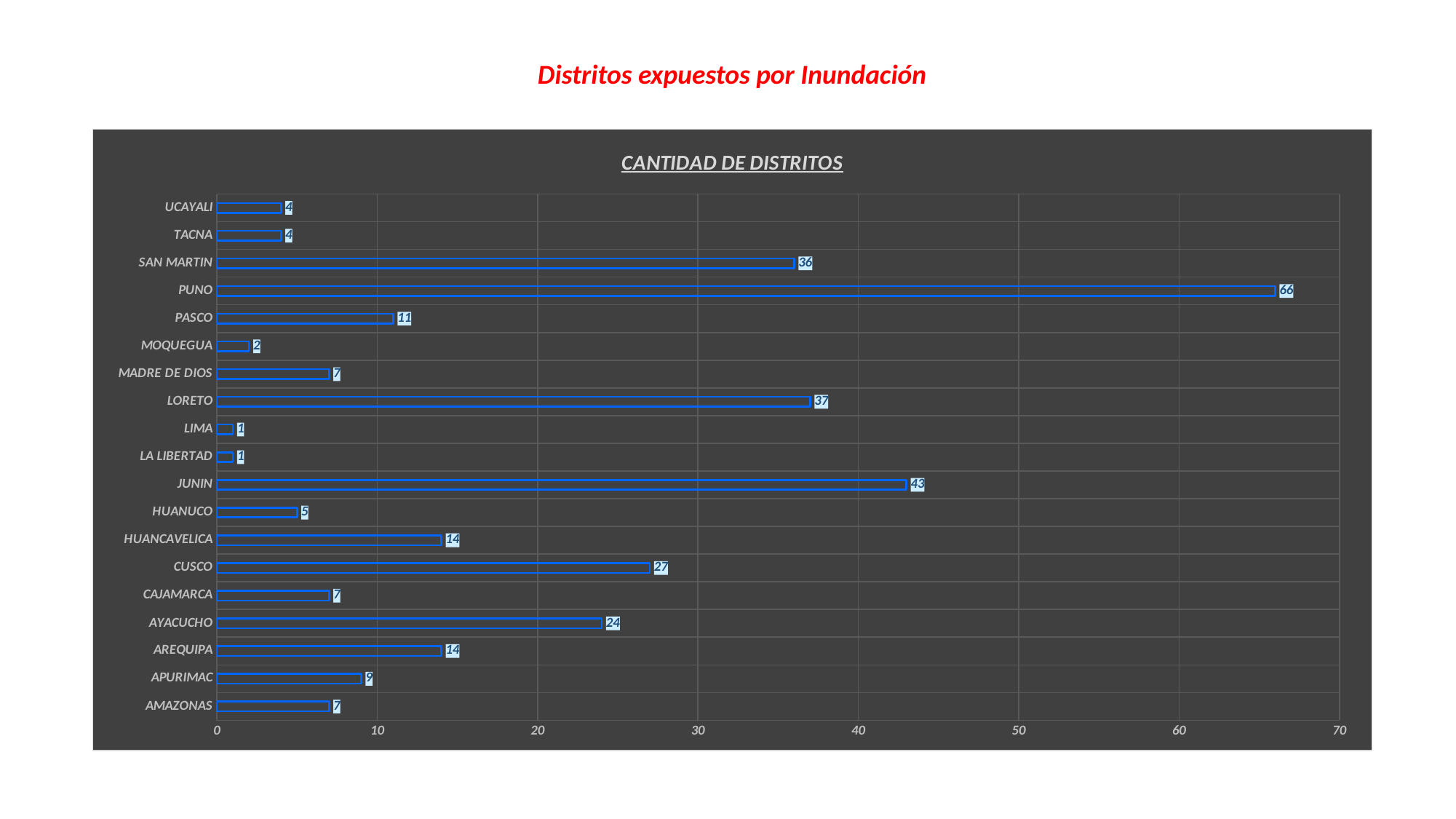
What kind of chart is shown on the slide? bar chart What is the value for LORETO? 37 What is the value for MOQUEGUA? 2 Is the value for PUNO greater or less than 60? greater What is the difference between the values for CUSCO and AYACUCHO? 3 What is the title of the chart? CANTIDAD DE DISTRITOS What is the value for PUNO? 66 How many categories are shown in the chart? 19 Which is larger, the value for JUNIN or the value for CUSCO? JUNIN What is the difference between the values for PUNO and JUNIN? 23 Which category has the highest value? PUNO What is the value for HUANCAVELICA? 14